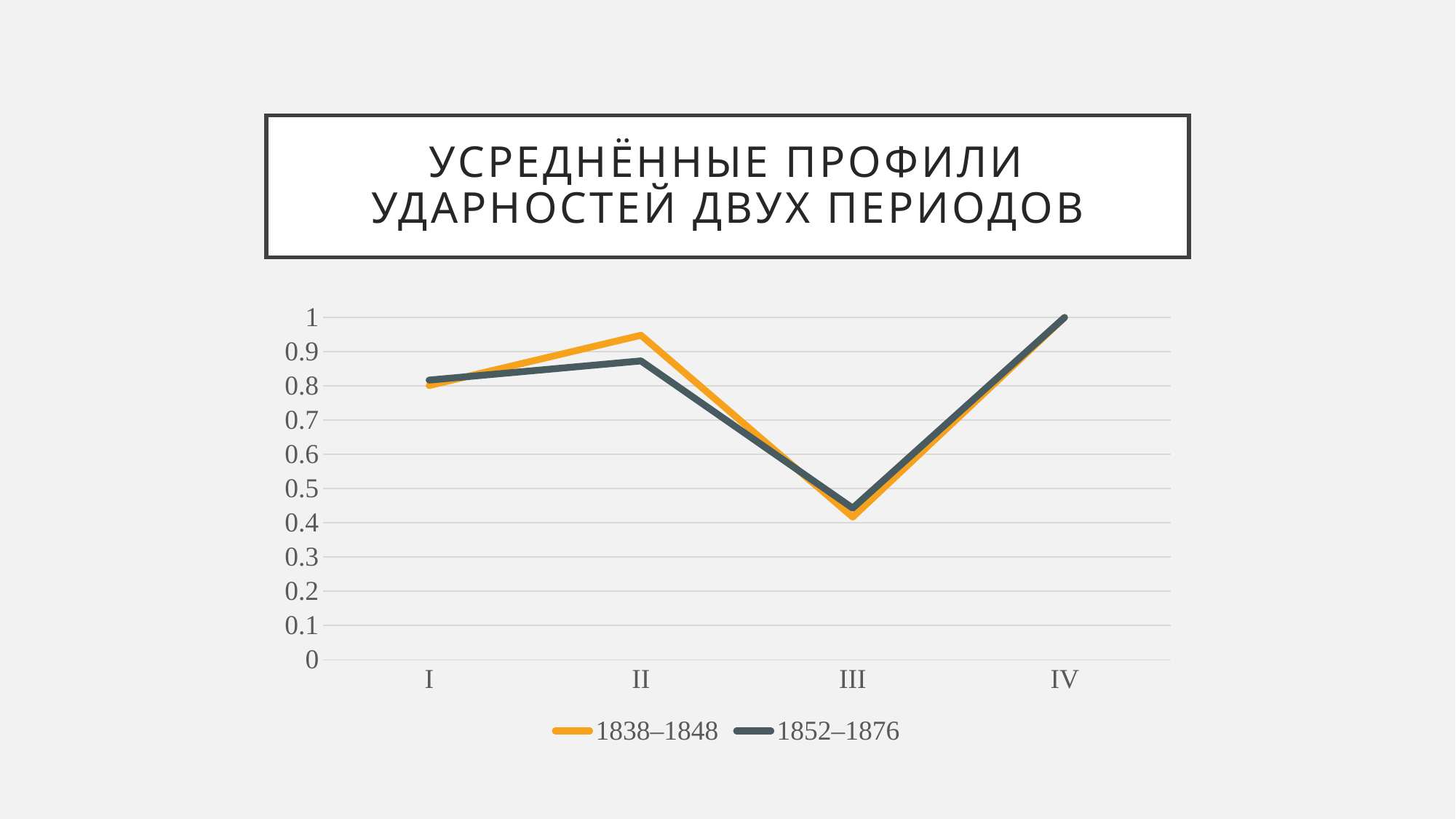
What kind of chart is shown on the slide? line chart How many categories are shown on the x axis? 4 Which series is drawn in orange? 1838–1848 Do the values of the 1852–1876 series rise or fall from category II to category III? fall Is the value for category II in the 1852–1876 series greater or less than 0.8? greater Which category has the lowest value for the 1852–1876 series? III How many series does the legend list? 2 Which category has the highest value for the 1838–1848 series? IV What is the title of the chart? УСРЕДНЁННЫЕ ПРОФИЛИ УДАРНОСТЕЙ ДВУХ ПЕРИОДОВ What is the value for category IV in the 1852–1876 series? 1 At category II, which series has the larger value, 1838–1848 or 1852–1876? 1838–1848 Is the value for category III in the 1838–1848 series greater or less than 0.5? less